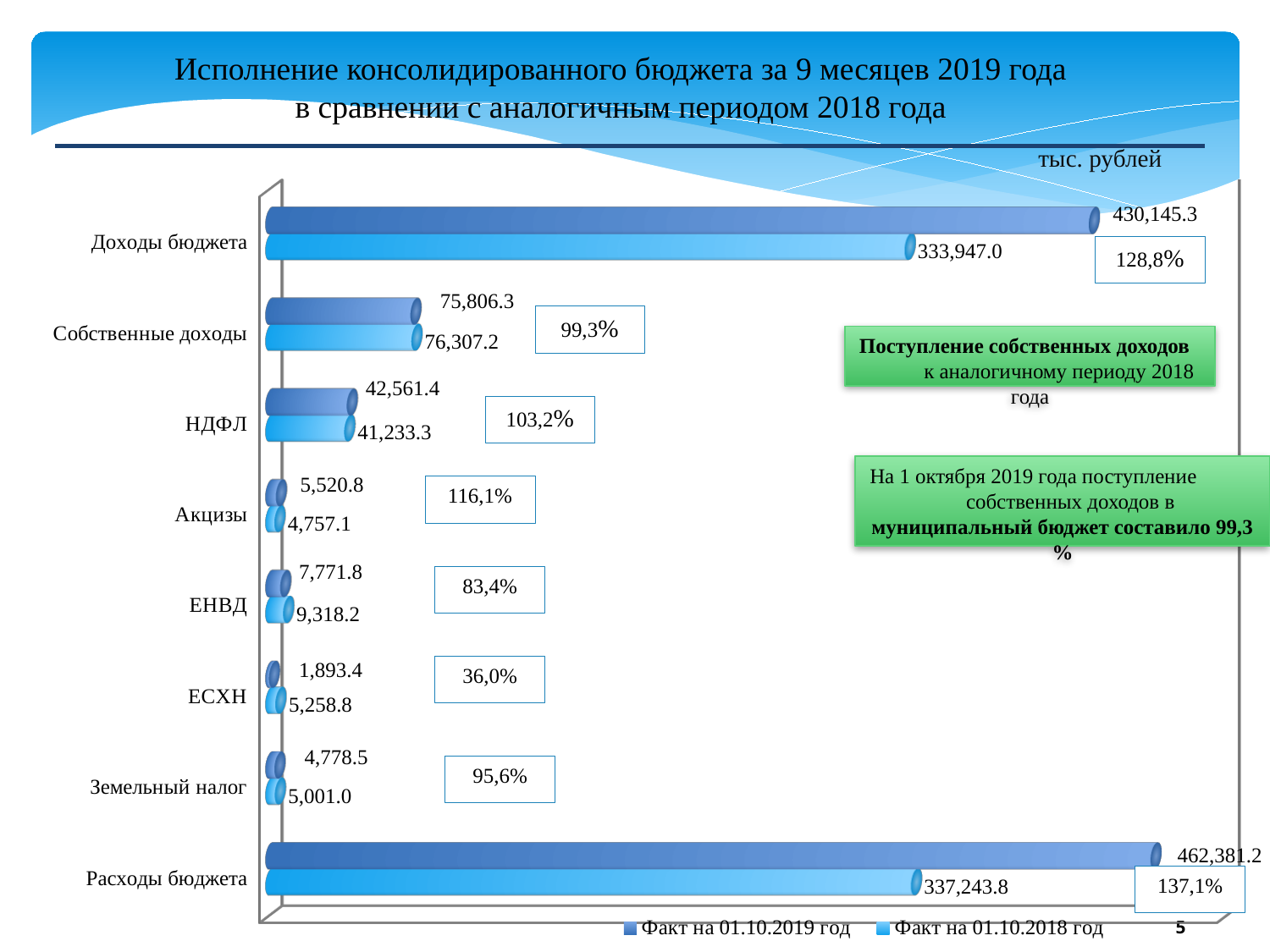
For Акцизы, which is larger: the value for Факт на 01.10.2019 год or Факт на 01.10.2018 год? Факт на 01.10.2019 год What is the value for НДФЛ in the series Факт на 01.10.2019 год? 42,561.4 What kind of chart is shown on the slide? Bar chart What is the difference between the 2019 and 2018 values for Доходы бюджета? 96,198.3 What is the value for Доходы бюджета in the series Факт на 01.10.2019 год? 430,145.3 For Собственные доходы, which is larger: the value for Факт на 01.10.2019 год or Факт на 01.10.2018 год? Факт на 01.10.2018 год Which category has the lowest value in the series Факт на 01.10.2019 год? ЕСХН What is the value for ЕНВД in the series Факт на 01.10.2018 год? 9,318.2 How many series does the legend list? 2 How many categories are shown on the chart? 8 Which category has the highest value in the series Факт на 01.10.2019 год? Расходы бюджета What is the difference between the 2018 and 2019 values for ЕСХН? 3,365.4